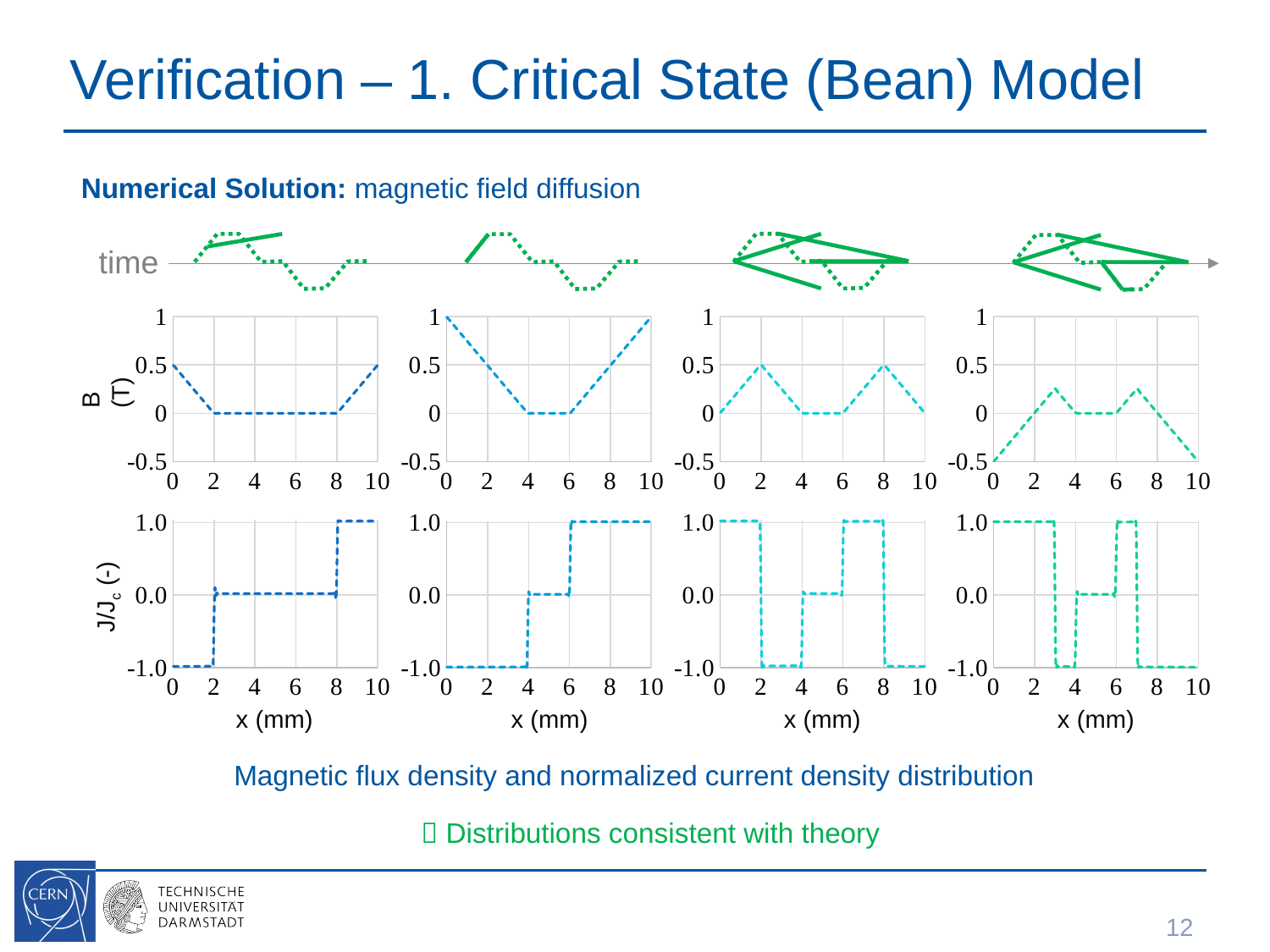
In the third top-row B (T) chart from the left, what is the value of B at x = 2 mm? 0.5 What is the x-axis label shared by the charts? x (mm) In the leftmost bottom-row J/Jc chart, what is the value of J/Jc at x = 9 mm? 1.0 In the rightmost top-row B (T) chart, is the value of B at x = 3 mm greater or less than 0? greater In the leftmost top-row B (T) chart, what is the value of B at x = 0 mm? 0.5 In the second bottom-row J/Jc chart from the left, what is the value of J/Jc at x = 2 mm? -1.0 What kind of charts are shown on the slide? Line charts How many small charts are shown on the slide in total? 8 In the second top-row B (T) chart from the left, what is the value of B at x = 0 mm? 1 In the rightmost top-row B (T) chart, what is the value of B at x = 0 mm? -0.5 In the leftmost top-row B (T) chart, does B rise or fall as x goes from 0 mm to 2 mm? Fall What is the y-axis label of the top row of charts? B (T)